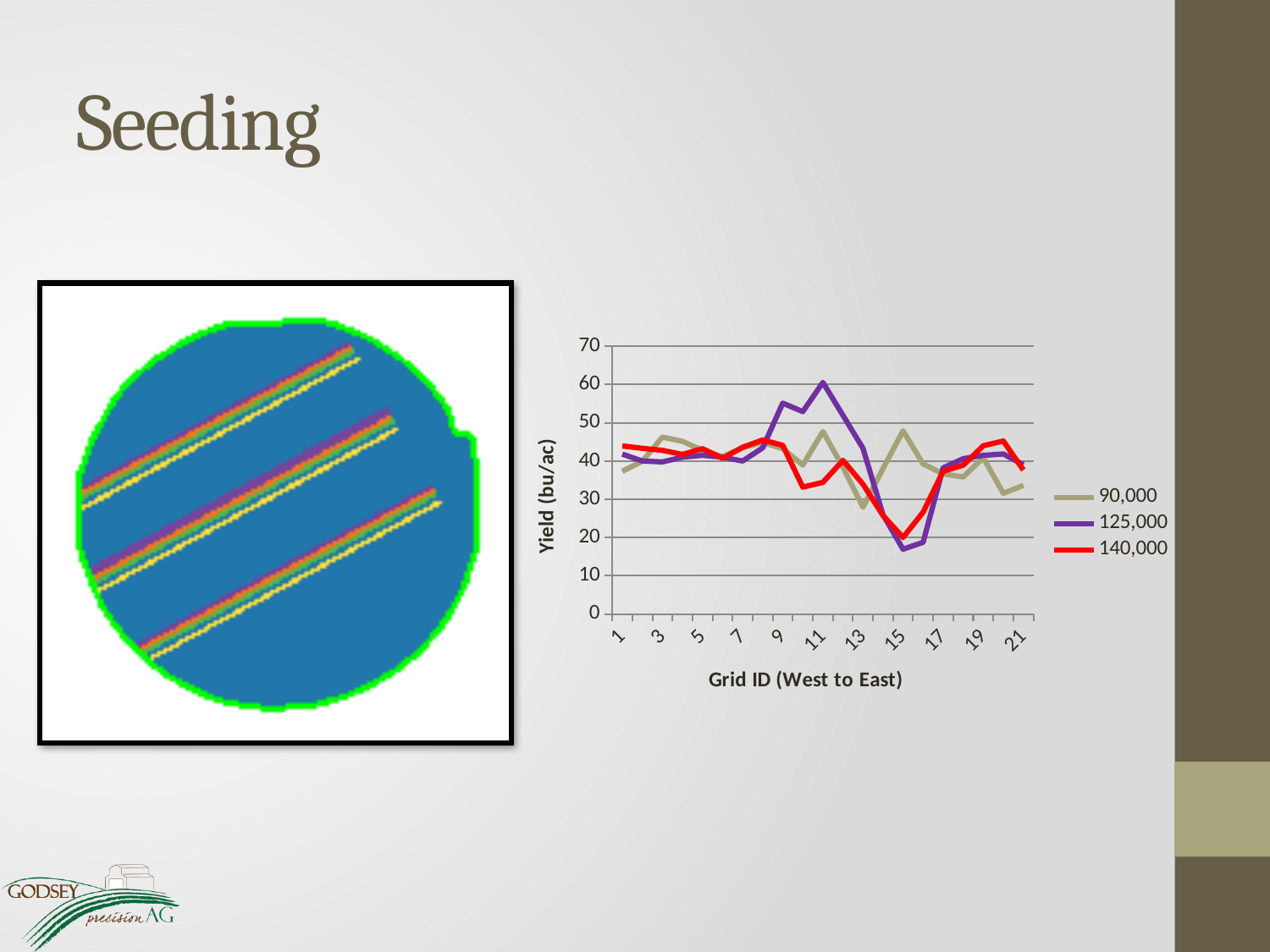
Which series reaches the highest yield anywhere on the chart? 125,000 Is the value for the 140,000 series at Grid ID 15 greater or less than 30? less Is the value for the 125,000 series at Grid ID 11 greater or less than 50? greater What is the title of the y axis? Yield (bu/ac) What is the title of the x axis? Grid ID (West to East) How many Grid ID points are plotted along the x axis? 21 At Grid ID 15, which series has the higher yield, 90,000 or 125,000? 90,000 What kind of chart is shown on the slide? line chart Is the value for the 125,000 series at Grid ID 15 greater or less than 30? less At Grid ID 11, which series has the higher yield, 125,000 or 90,000? 125,000 How many series does the chart legend list? 3